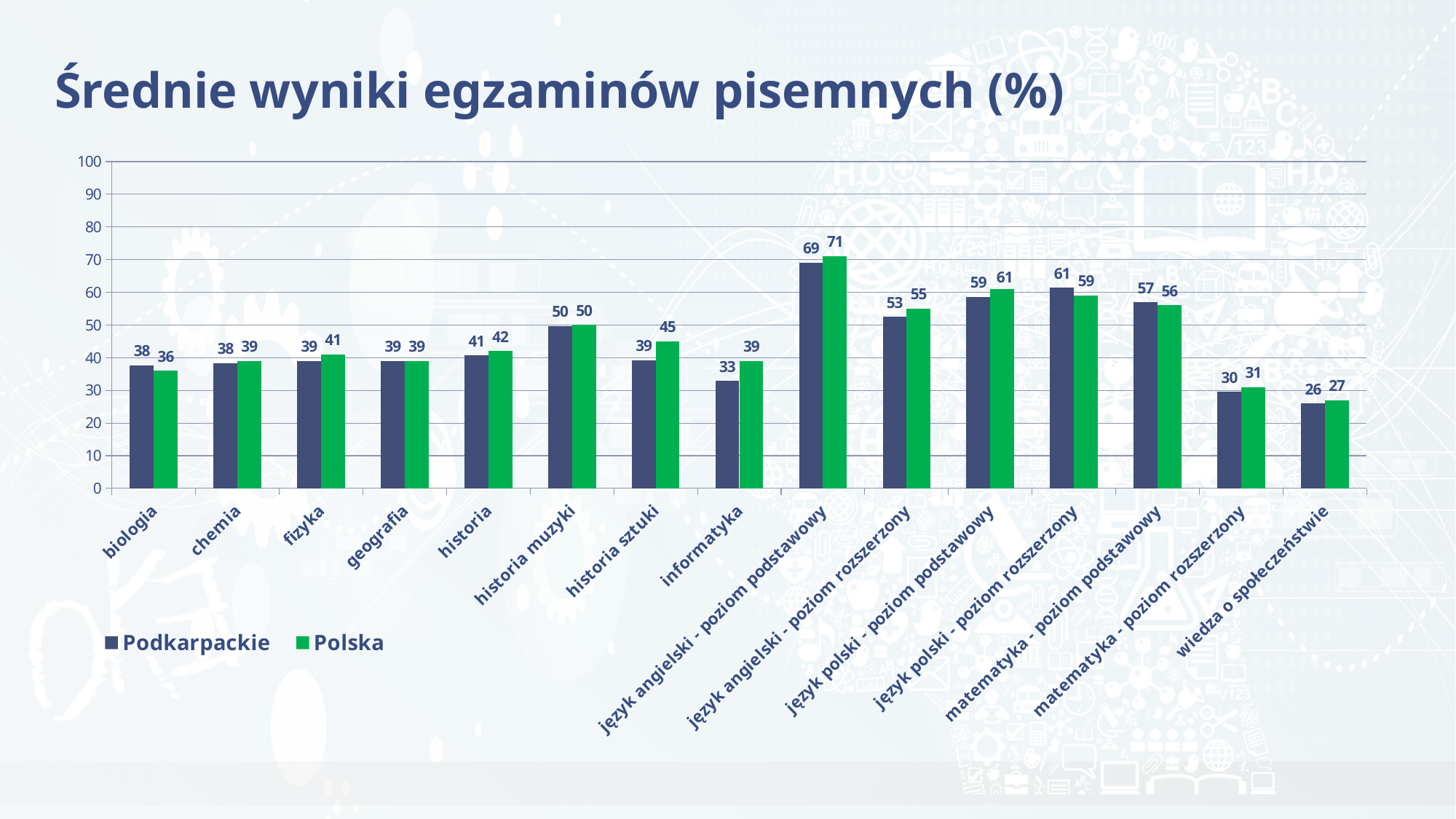
What is the title of the chart? Średnie wyniki egzaminów pisemnych (%) What kind of chart is shown on the slide? bar chart Which category has the lowest value for Podkarpackie? wiedza o społeczeństwie Which category has the highest value for Polska? język angielski - poziom podstawowy What is the value for Podkarpackie in biologia? 38 What is the value for Polska in informatyka? 39 What is the difference between the Polska and Podkarpackie values for informatyka? 6 Which is larger for język polski - poziom rozszerzony: Podkarpackie or Polska? Podkarpackie What is the value for Polska in historia sztuki? 45 How many series does the legend list? 2 Is the value for Podkarpackie in matematyka - poziom podstawowy greater or less than 50? greater How many categories are shown on the x axis? 15